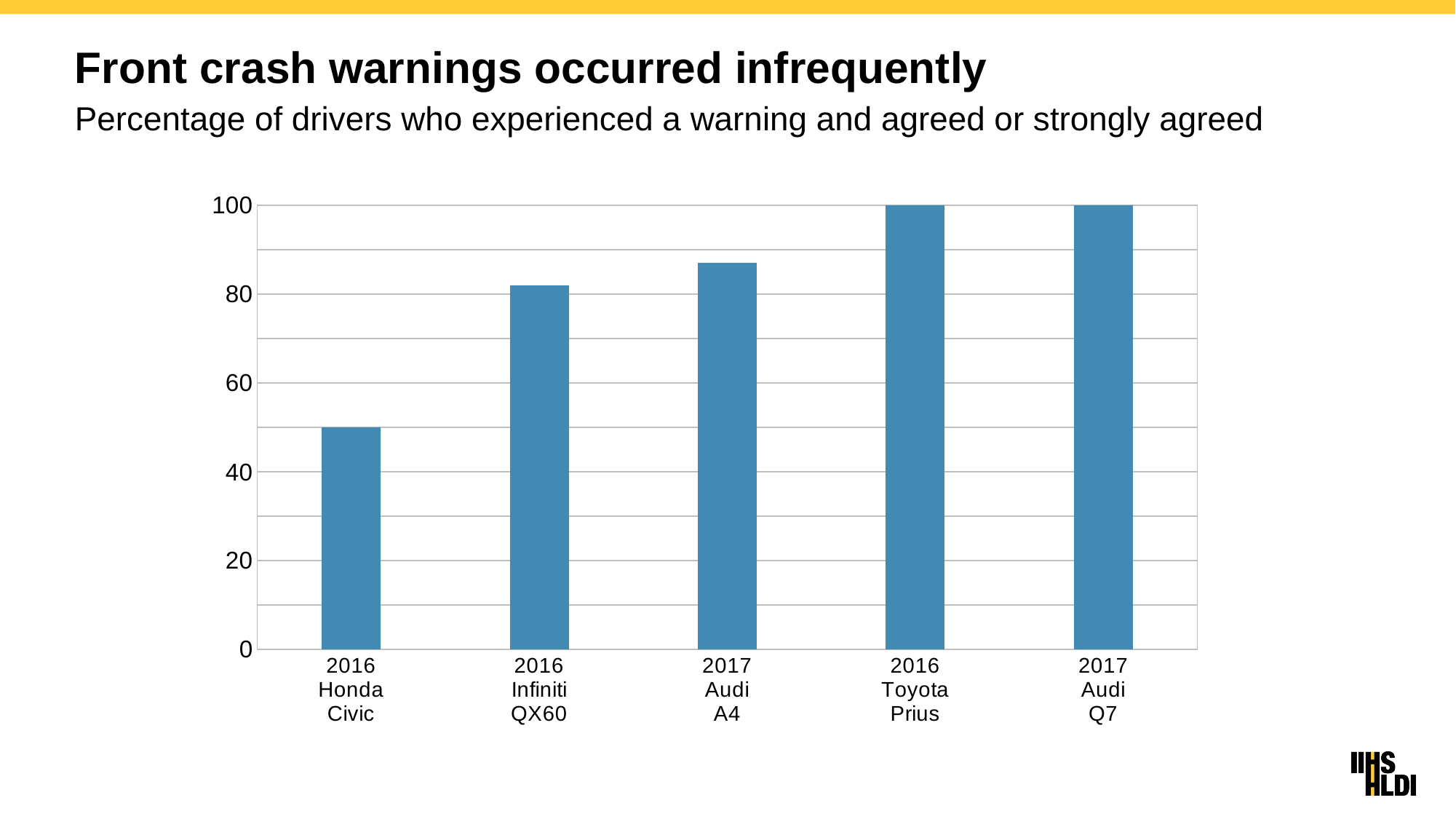
How many vehicle categories are shown on the x axis? 5 What kind of chart is shown on the slide? bar chart Is the value for the 2016 Honda Civic greater or less than 40? greater Do the values generally rise or fall moving from left to right along the x axis? rise What is the value for the 2017 Audi Q7? 100 Which vehicle has the lowest percentage? 2016 Honda Civic Is the value for the 2016 Infiniti QX60 greater or less than 60? greater What is the title of the slide? Front crash warnings occurred infrequently What is the value for the 2016 Toyota Prius? 100 Is the value for the 2017 Audi A4 greater or less than 80? greater Which is larger, the value for the 2016 Honda Civic or the 2016 Infiniti QX60? 2016 Infiniti QX60